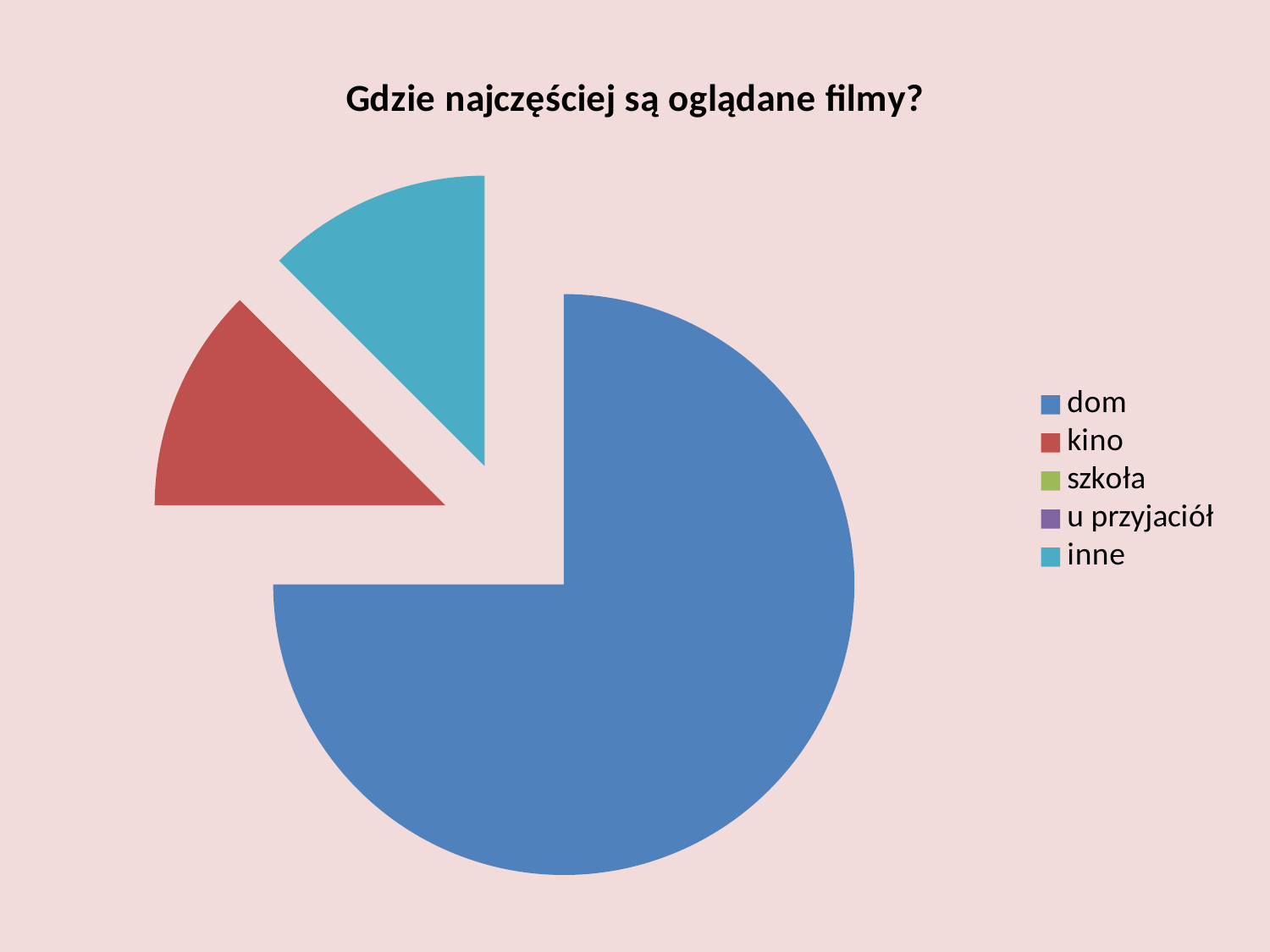
What kind of chart is shown on the slide? pie chart Is the share of the pie for kino greater or less than 25%? less How many entries does the chart's legend list? 5 Is the share of the pie for dom greater or less than 50%? greater What colour is the slice for dom? blue How many slices are visibly drawn in the pie? 3 What is the title of the chart? Gdzie najczęściej są oglądane filmy? Which slice is larger, dom or kino? dom Which slice is larger, dom or inne? dom Which category has the largest slice of the pie? dom